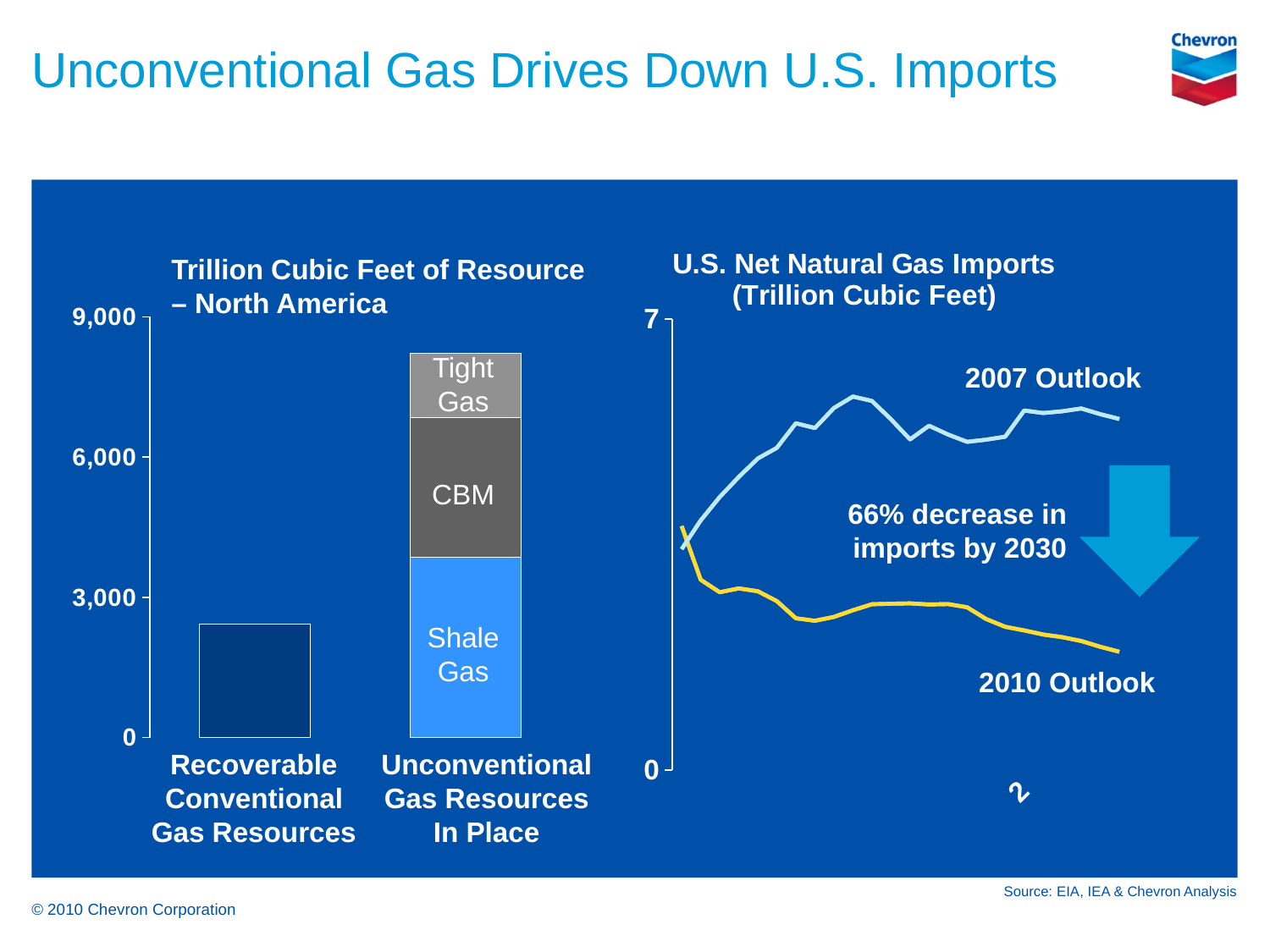
In the right chart 'U.S. Net Natural Gas Imports (Trillion Cubic Feet)', what percentage decrease in imports by 2030 is annotated? 66% In the right chart 'U.S. Net Natural Gas Imports (Trillion Cubic Feet)', how many series (outlook lines) are plotted? 2 In the right chart 'U.S. Net Natural Gas Imports (Trillion Cubic Feet)', which line is higher at the right end, 2007 Outlook or 2010 Outlook? 2007 Outlook In the left chart 'Trillion Cubic Feet of Resource – North America', which category has the taller bar? Unconventional Gas Resources In Place In the right chart 'U.S. Net Natural Gas Imports (Trillion Cubic Feet)', does the 2010 Outlook line rise or fall along the x axis? fall In the left chart 'Trillion Cubic Feet of Resource – North America', how many categories are shown on the x axis? 2 In the left chart 'Trillion Cubic Feet of Resource – North America', how many segments make up the Unconventional Gas Resources In Place bar? 3 In the left chart 'Trillion Cubic Feet of Resource – North America', which segment is at the bottom of the Unconventional Gas Resources In Place stacked bar? Shale Gas In the left chart 'Trillion Cubic Feet of Resource – North America', is the value for Recoverable Conventional Gas Resources greater or less than 3,000? less What kind of chart is the right chart titled 'U.S. Net Natural Gas Imports (Trillion Cubic Feet)'? line chart What kind of chart is the left chart titled 'Trillion Cubic Feet of Resource – North America'? bar chart In the left chart 'Trillion Cubic Feet of Resource – North America', is the total height of the Unconventional Gas Resources In Place bar greater or less than 6,000? greater